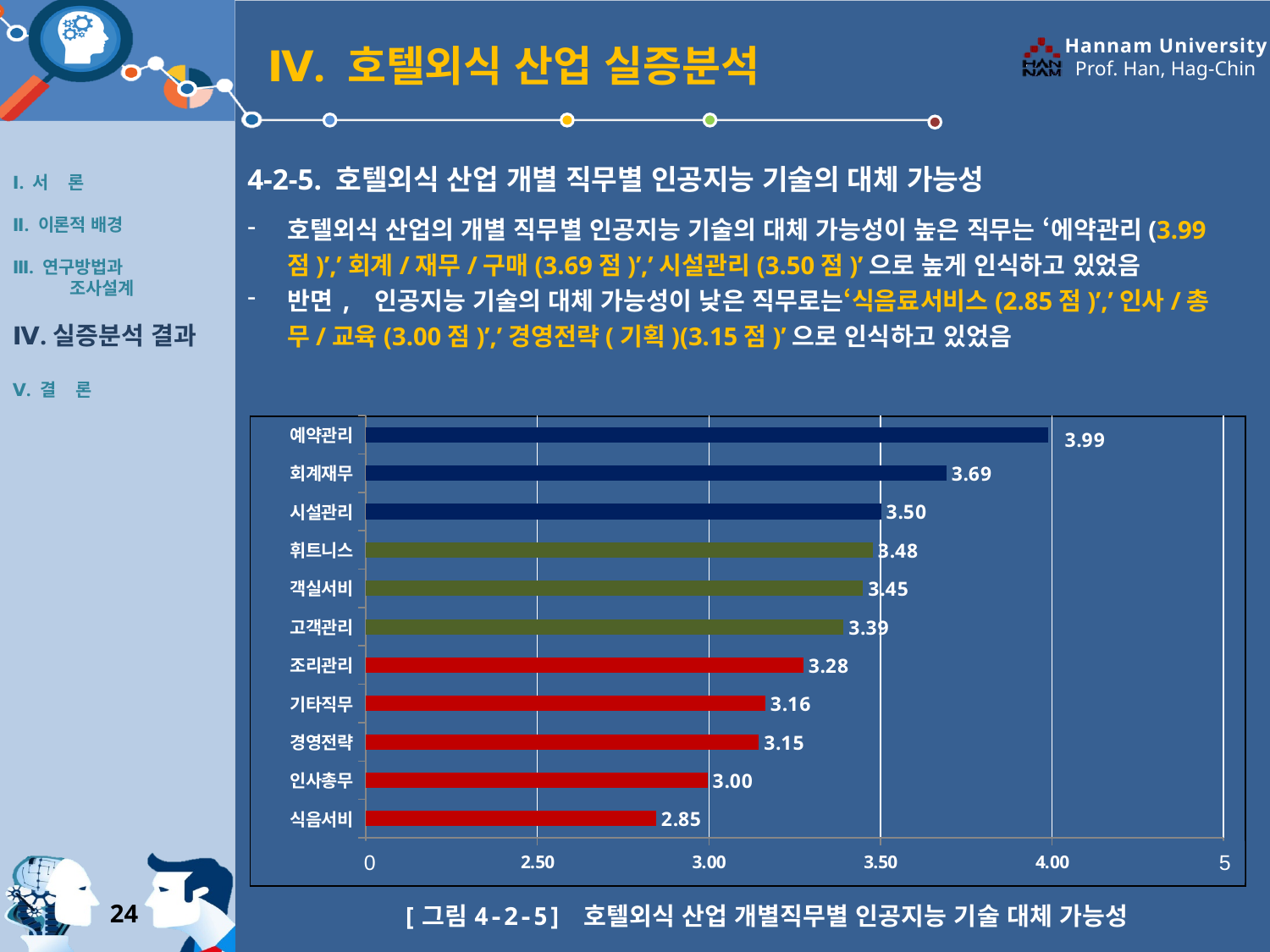
What kind of chart is shown on the slide? bar chart What is the value for 조리관리? 3.28 What colour are the bars for the three highest categories (예약관리, 회계재무, 시설관리)? dark blue How many categories are shown in the chart? 11 What is the difference between the values for 회계재무 and 시설관리? 0.19 Which category has the lowest value? 식음서비 Which is larger, the value for 휘트니스 or the value for 고객관리? 휘트니스 What is the value for 시설관리? 3.50 What is the value for 예약관리? 3.99 Which category has the highest value? 예약관리 What is the difference between the values for 예약관리 and 식음서비? 1.14 What is the value for 인사총무? 3.00